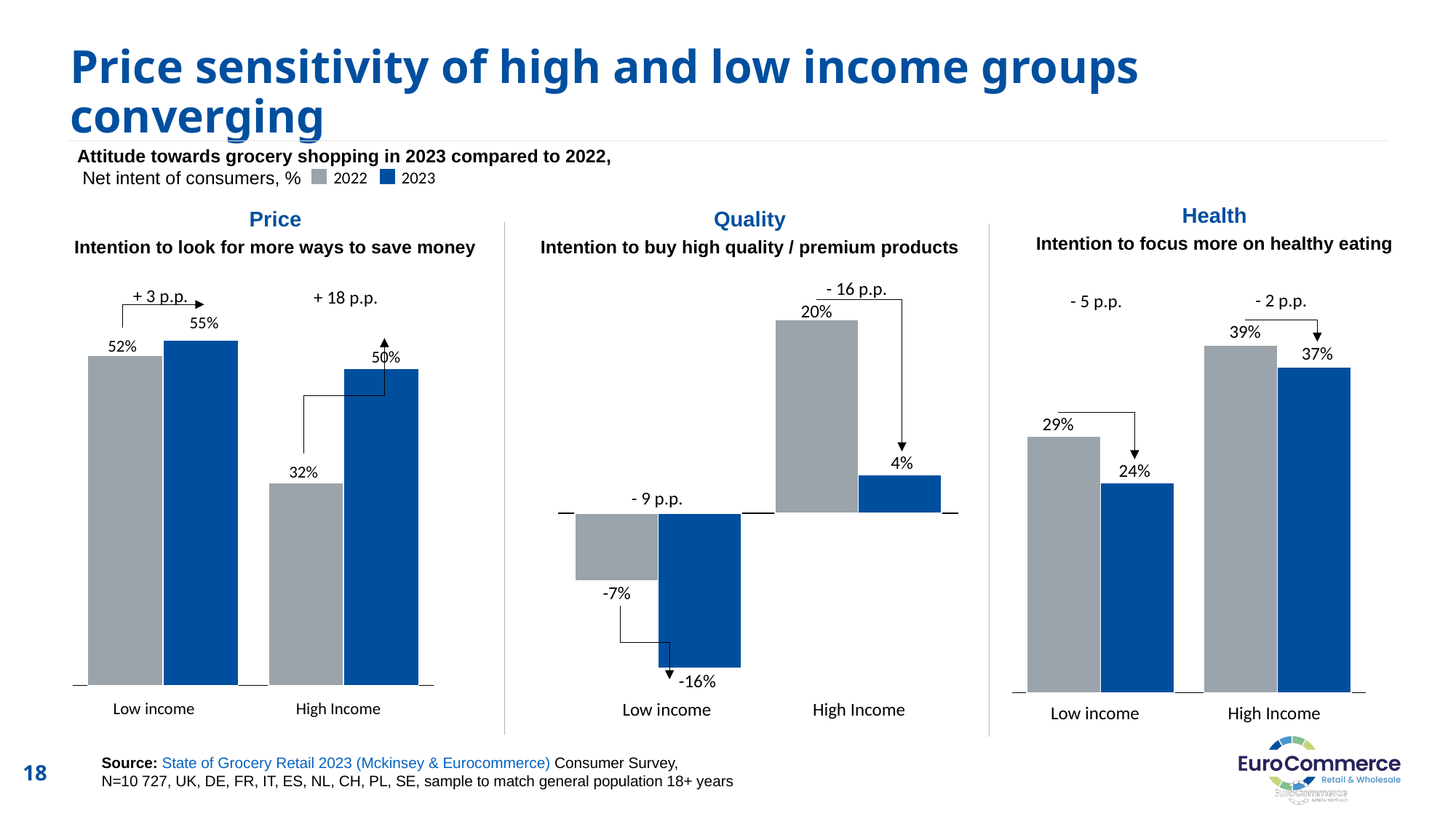
Which colour represents 2023 in the charts? Blue In the Price chart, what is the difference between the 2022 and 2023 values for High Income? 18 p.p. In the Quality chart, what is the 2023 value for Low income? -16% In the Health chart, what is the 2023 value for High Income? 37% In the Price chart, which group has the higher 2023 value, Low income or High Income? Low income In the Health chart, what is the difference between the 2022 and 2023 values for Low income? 5 p.p. In the Quality chart, what is the 2022 value for High Income? 20% In the Quality chart, which bar has the lowest value? Low income 2023 (-16%) What kind of chart is the Health chart? Bar chart In the Price chart, what is the 2022 value for High Income? 32% How many series does the legend list? 2 In the Price chart, what is the 2023 value for Low income? 55%